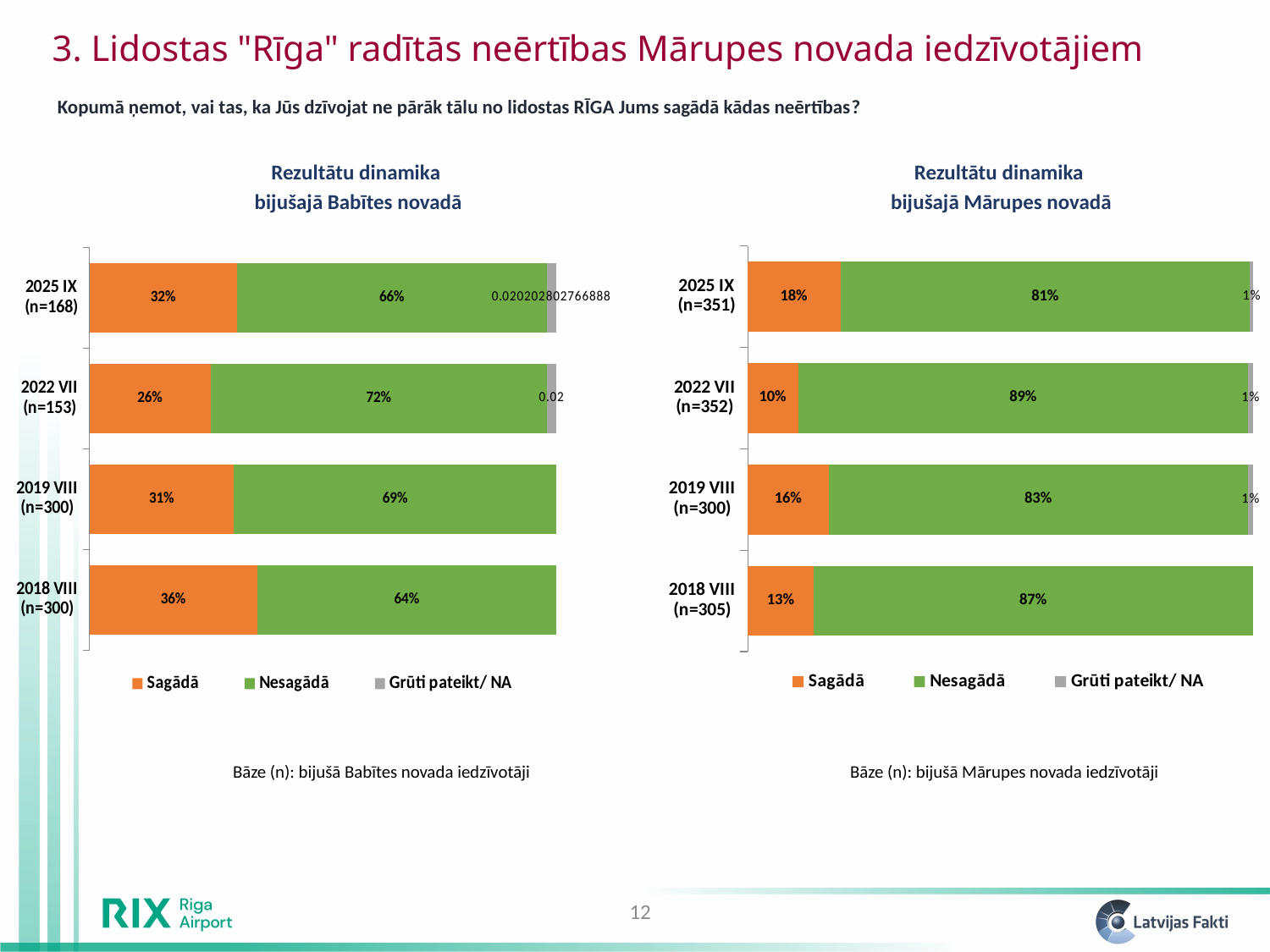
In the chart 'Rezultātu dinamika bijušajā Mārupes novadā', which period has the highest Sagādā value? 2025 IX (n=351) In the chart 'Rezultātu dinamika bijušajā Babītes novadā', which period has the highest Sagādā value? 2018 VIII (n=300) In the chart 'Rezultātu dinamika bijušajā Babītes novadā', what is the Nesagādā value for 2022 VII (n=153)? 72% In the chart 'Rezultātu dinamika bijušajā Mārupes novadā', is the Sagādā value larger for 2019 VIII (n=300) or for 2018 VIII (n=305)? 2019 VIII (n=300) In the chart 'Rezultātu dinamika bijušajā Babītes novadā', what is the difference between the Nesagādā values for 2022 VII (n=153) and 2018 VIII (n=300)? 8 percentage points How many series does the legend of the chart 'Rezultātu dinamika bijušajā Babītes novadā' list? 3 In the chart 'Rezultātu dinamika bijušajā Babītes novadā', which period has the lowest Sagādā value? 2022 VII (n=153) In the chart 'Rezultātu dinamika bijušajā Mārupes novadā', what is the Sagādā value for 2018 VIII (n=305)? 13% In the chart 'Rezultātu dinamika bijušajā Mārupes novadā', what is the Nesagādā value for 2022 VII (n=352)? 89% In the chart 'Rezultātu dinamika bijušajā Mārupes novadā', what is the difference between the Sagādā values for 2025 IX (n=351) and 2022 VII (n=352)? 8 percentage points In the chart 'Rezultātu dinamika bijušajā Babītes novadā', what is the Sagādā value for 2025 IX (n=168)? 32% How many periods (bars) are shown in the chart 'Rezultātu dinamika bijušajā Mārupes novadā'? 4